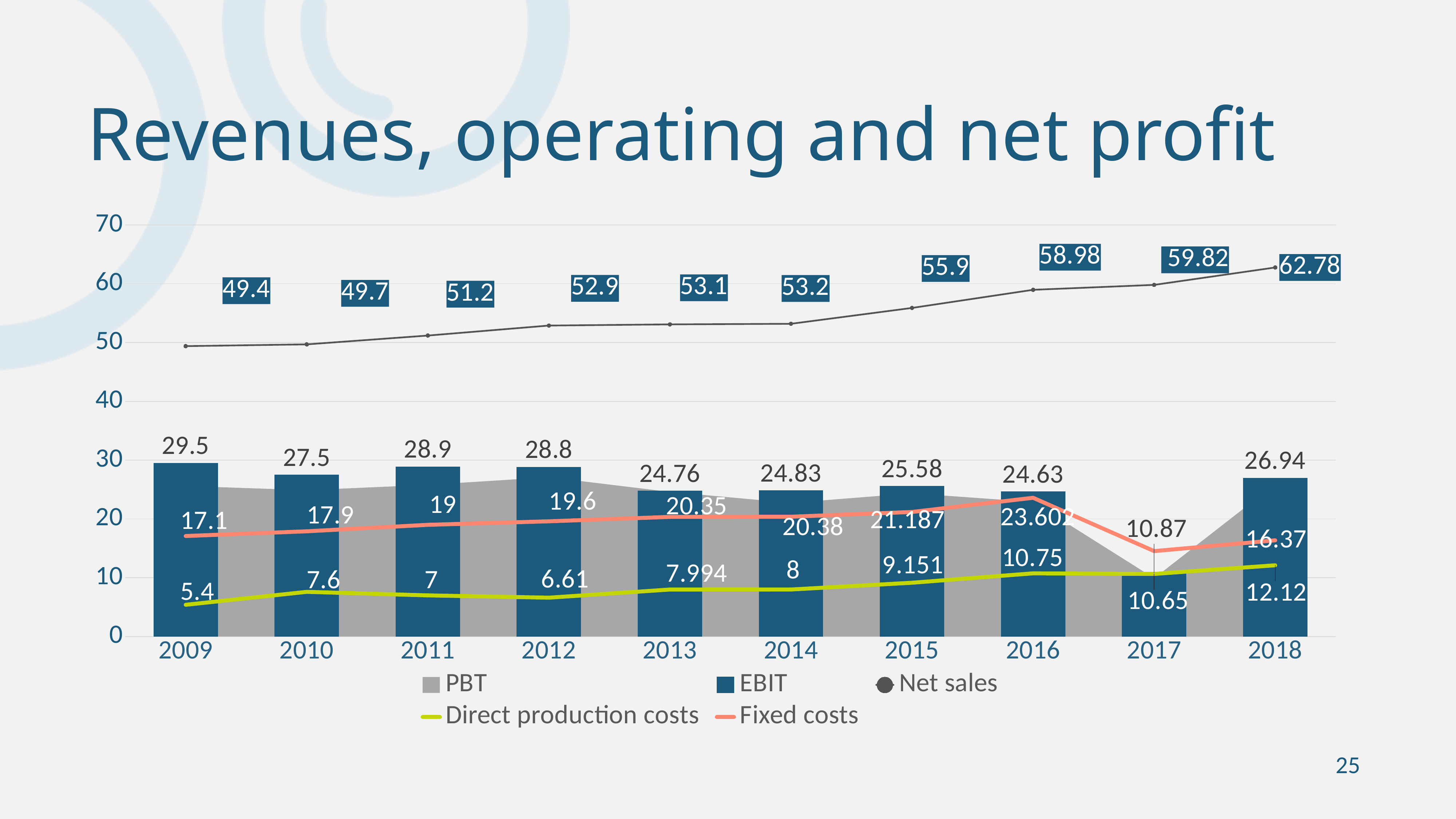
What is the difference between Net sales in 2018 and Net sales in 2009? 13.38 What is the Fixed costs value for 2015? 21.187 In which year is EBIT highest? 2009 How many series does the legend list? 5 Is the PBT value for 2017 greater or less than 20? less What is the EBIT value for 2009? 29.5 In which year is EBIT lowest? 2017 What is the Net sales value for 2018? 62.78 What is the Direct production costs value for 2013? 7.994 How many years are shown on the x axis? 10 Do the Net sales values rise or fall from 2009 to 2018? rise Which year has the larger EBIT value, 2011 or 2012? 2011